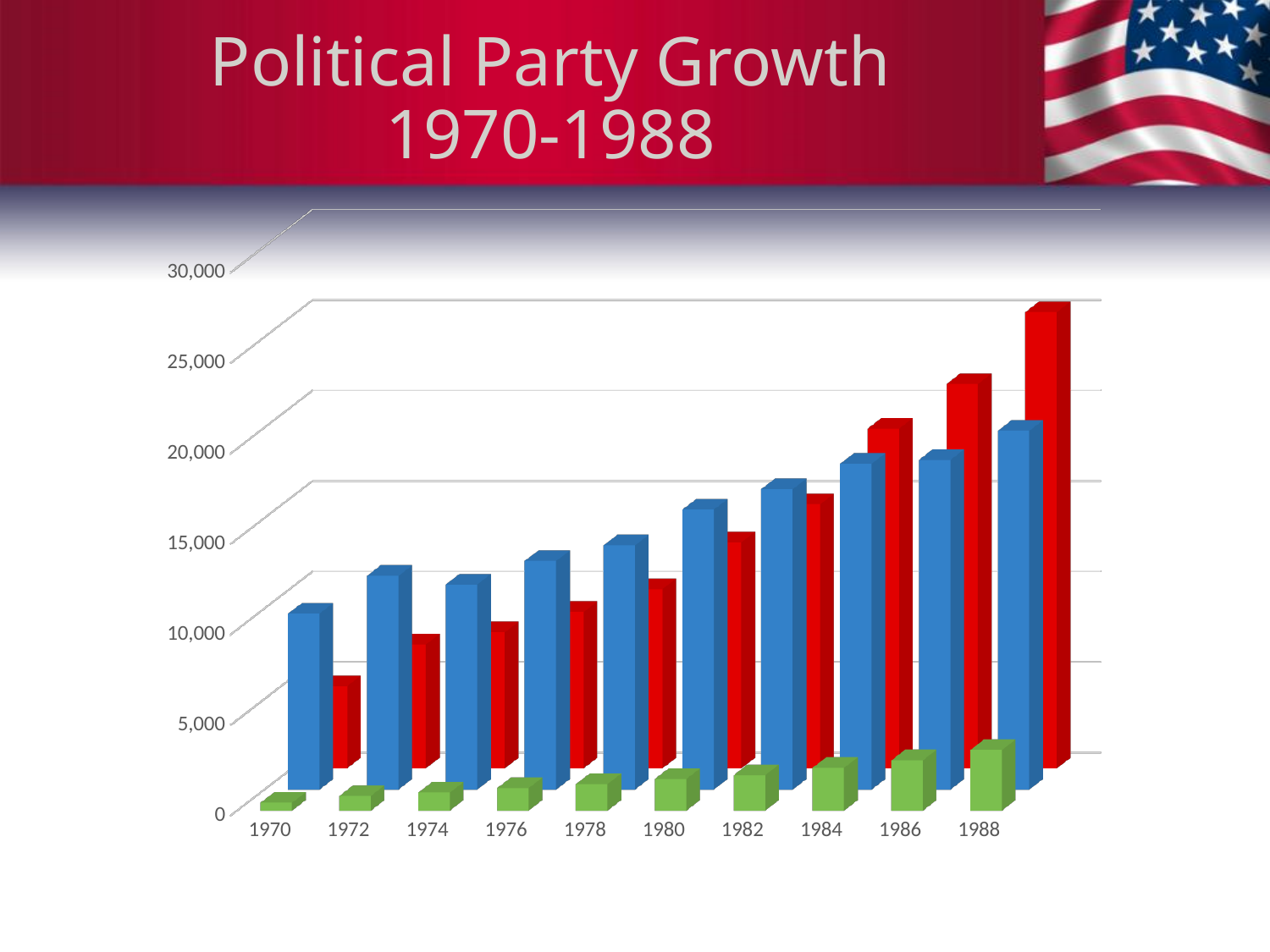
In which year is the red series at its highest? 1988 What is the title of the chart slide? Political Party Growth 1970-1988 In which year is the green series at its highest? 1988 How many years are shown along the x axis of the chart? 10 Is the value of the red bar for 1970 greater or less than 10,000? less What kind of chart is shown on the slide? Bar chart How many data series (bar colours) are plotted in the chart? 3 Is the value of the red bar for 1988 greater or less than 25,000? greater In 1970, which is larger, the blue bar or the red bar? The blue bar Does the red series generally rise or fall from 1970 to 1988? Rise Is the value of the green bar for 1988 greater or less than 5,000? less In which year is the red series at its lowest? 1970